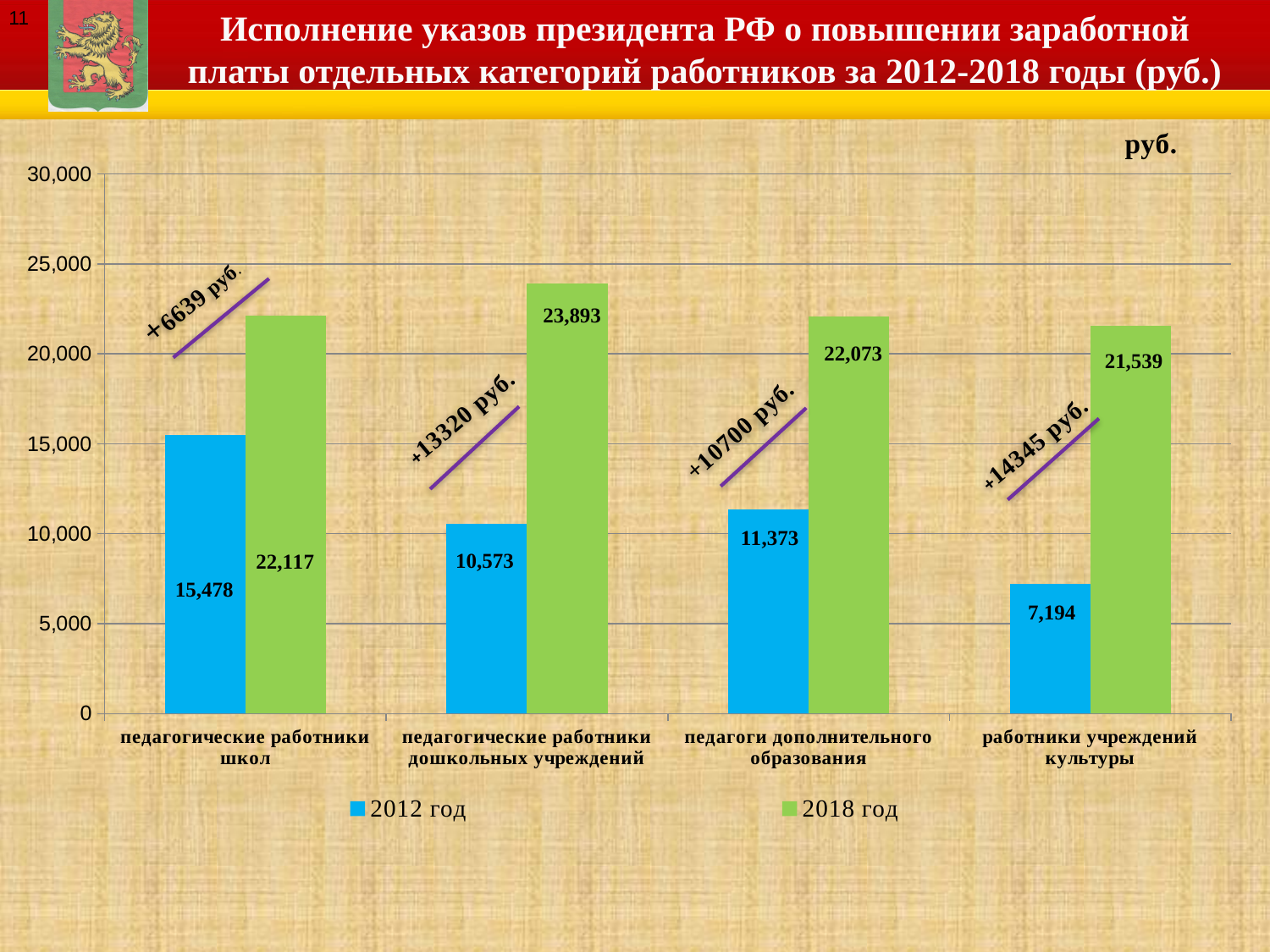
What kind of chart is shown on the slide? bar chart Which category has the lowest value in the 2012 год series? работники учреждений культуры What is the difference between the 2018 год and 2012 год values for работники учреждений культуры? 14,345 Which is larger: the 2012 год value for педагогические работники школ or the 2012 год value for педагоги дополнительного образования? педагогические работники школ Is the 2018 год value for педагогические работники школ greater or less than 20,000? greater How many series does the legend list? 2 What is the value for педагогические работники дошкольных учреждений in the 2018 год series? 23,893 Which category has the highest value in the 2018 год series? педагогические работники дошкольных учреждений What is the value for работники учреждений культуры in the 2012 год series? 7,194 What is the value for педагоги дополнительного образования in the 2018 год series? 22,073 How many categories are shown on the x axis? 4 What is the value for педагогические работники школ in the 2012 год series? 15,478